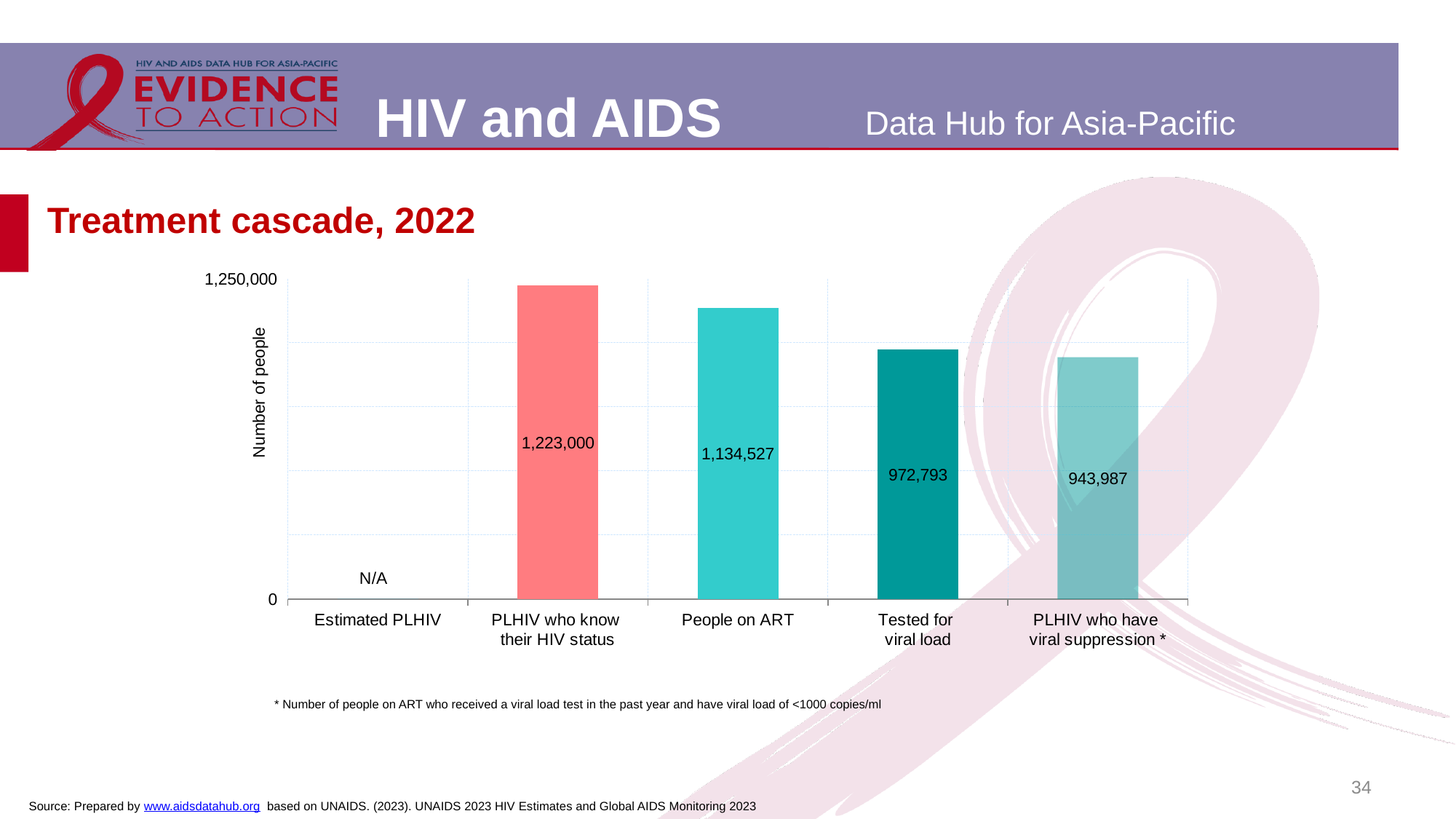
What is the difference between People on ART and Tested for viral load? 161,734 What is the value for Tested for viral load? 972,793 Do the bar values rise or fall from left to right across the plotted bars? fall Which category has the highest plotted value? PLHIV who know their HIV status Which category has the lowest plotted value among the bars shown? PLHIV who have viral suppression How many people on ART are shown in the chart? 1,134,527 What is the value for PLHIV who have viral suppression? 943,987 What is the difference between PLHIV who know their HIV status and People on ART? 88,473 What is the value for PLHIV who know their HIV status? 1,223,000 How many categories are on the x axis? 5 Which is larger, Tested for viral load or PLHIV who have viral suppression? Tested for viral load What is shown for the Estimated PLHIV category? N/A